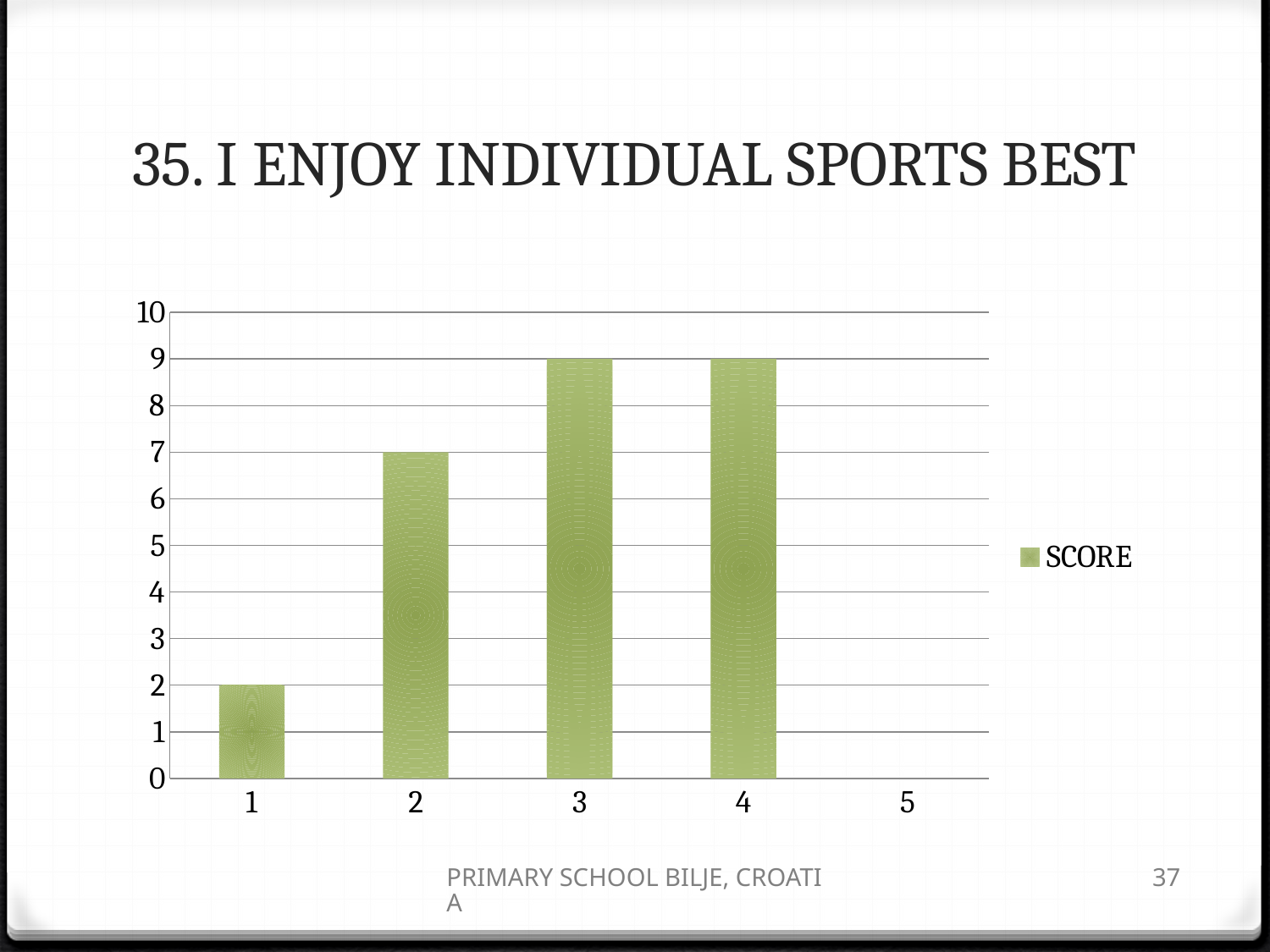
What is the value for category 4? 9 What kind of chart is shown on the slide? bar chart Is the value for category 2 greater or less than 5? greater How many categories are shown on the x axis? 5 What is the difference between the values for category 3 and category 2? 2 What is the value for category 1? 2 Among the bars drawn on the chart, which category has the lowest value? 1 What is the difference between the values for category 2 and category 1? 5 What is the value for category 3? 9 Which has a larger value, category 2 or category 1? 2 How many series does the legend list? 1 What is the value for category 2? 7